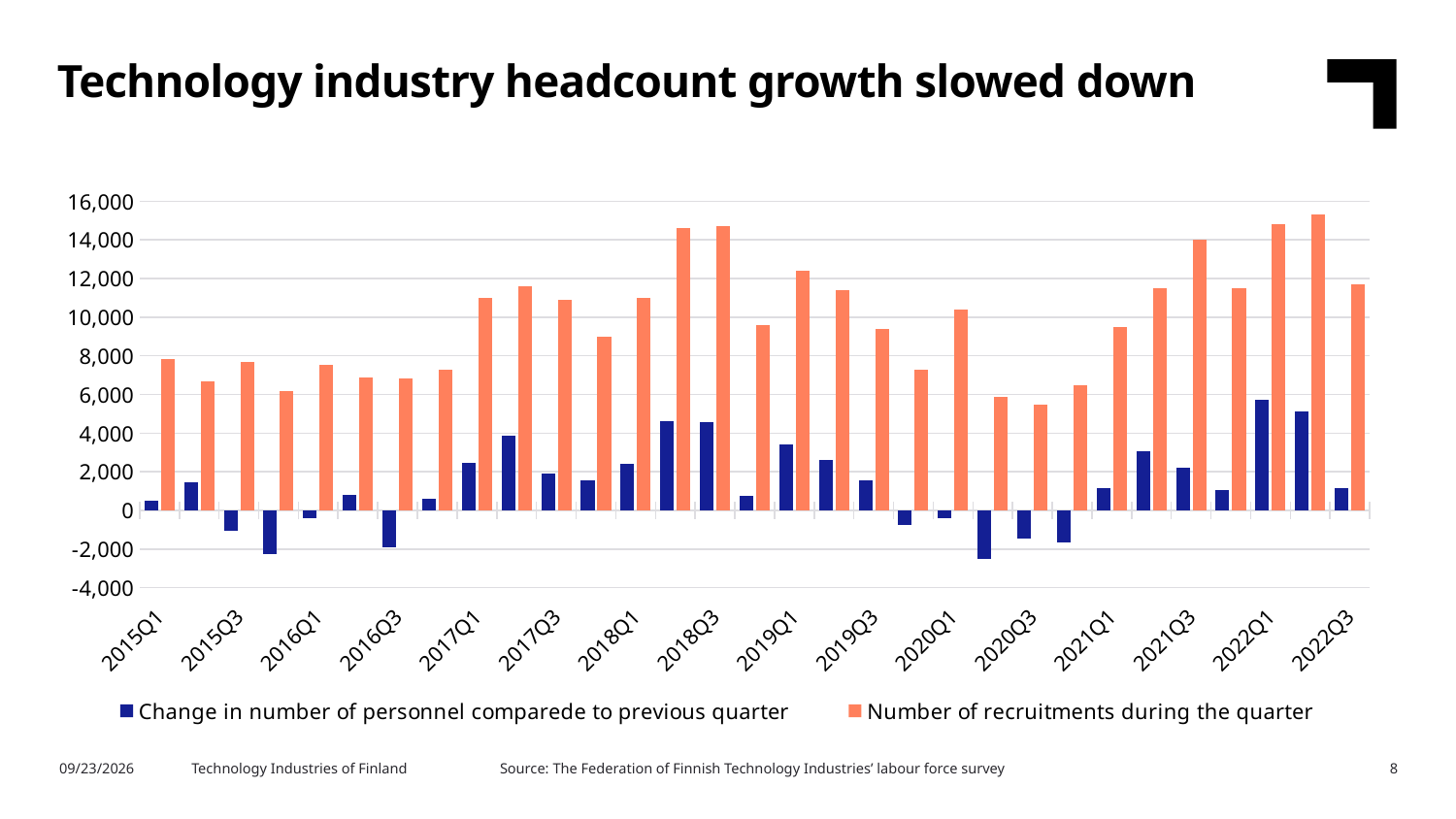
How many quarters are plotted on the x axis? 31 Is the change in number of personnel in 2022Q1 greater or less than 4,000? greater Is the number of recruitments in 2022Q3 greater or less than 10,000? greater Is the number of recruitments in 2020Q3 greater or less than 6,000? less How many series does the legend list? 2 Which series is shown in orange? Number of recruitments during the quarter Do the number of recruitments generally rise or fall from 2015Q1 to 2018Q3? rise Which quarter had more recruitments, 2018Q3 or 2015Q1? 2018Q3 Which quarter had a larger change in number of personnel, 2022Q1 or 2021Q3? 2022Q1 What kind of chart is shown on the slide? bar chart